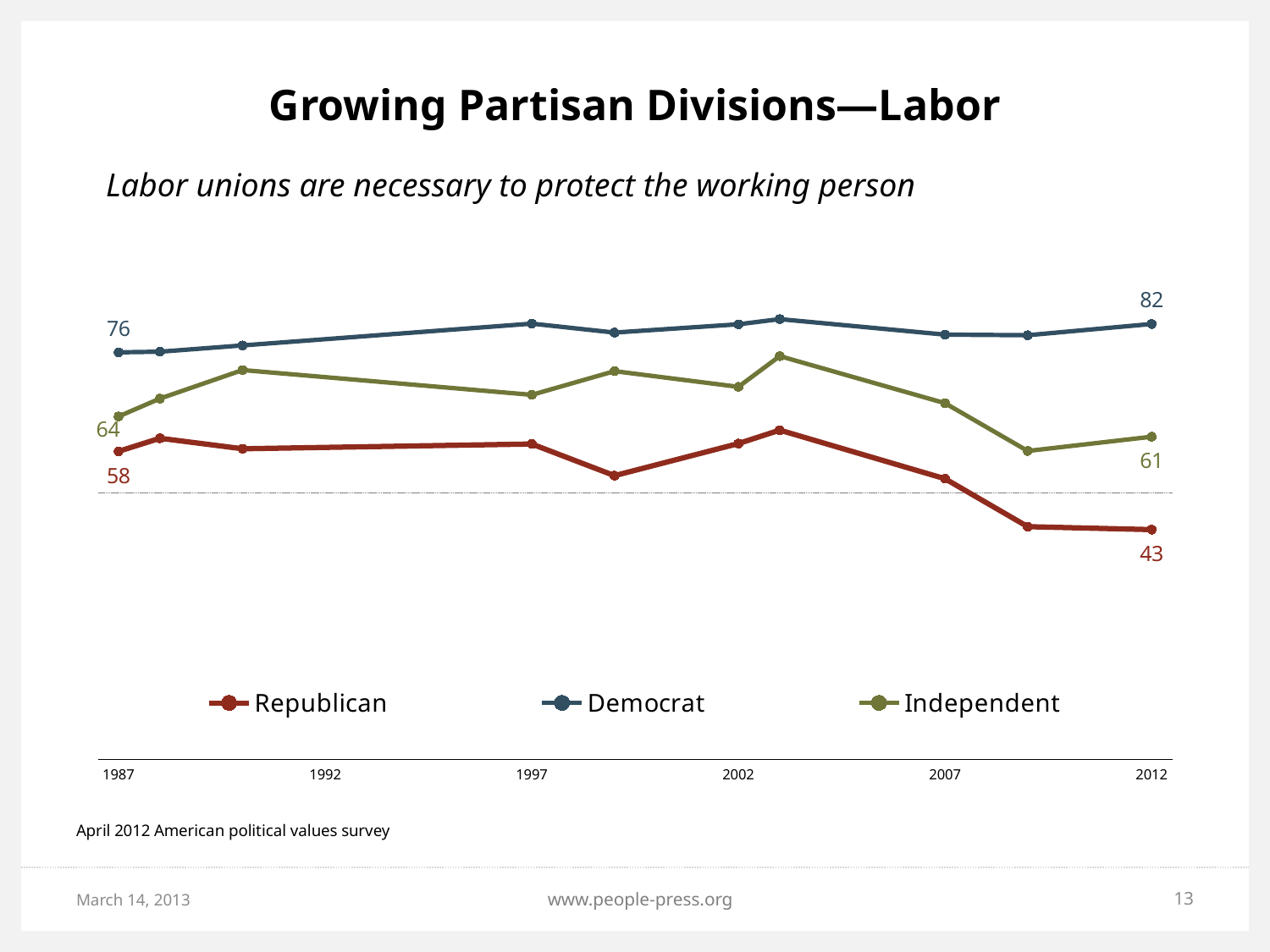
By how much did the Republican value fall from 1987 to 2012? 15 What is the difference between the Democrat and Republican values in 2012? 39 How many series does the legend list? 3 What is the value for Democrat in 1987? 76 Does the Republican line rise or fall from 1987 to 2012? Fall Which is larger in 1987, the Independent value or the Republican value? Independent What is the value for Republican in 1987? 58 What is the value for Independent in 2012? 61 What is the value for Republican in 2012? 43 Which series has the highest value in 2012? Democrat What kind of chart is shown on the slide? Line chart Which series has the lowest value in 2012? Republican